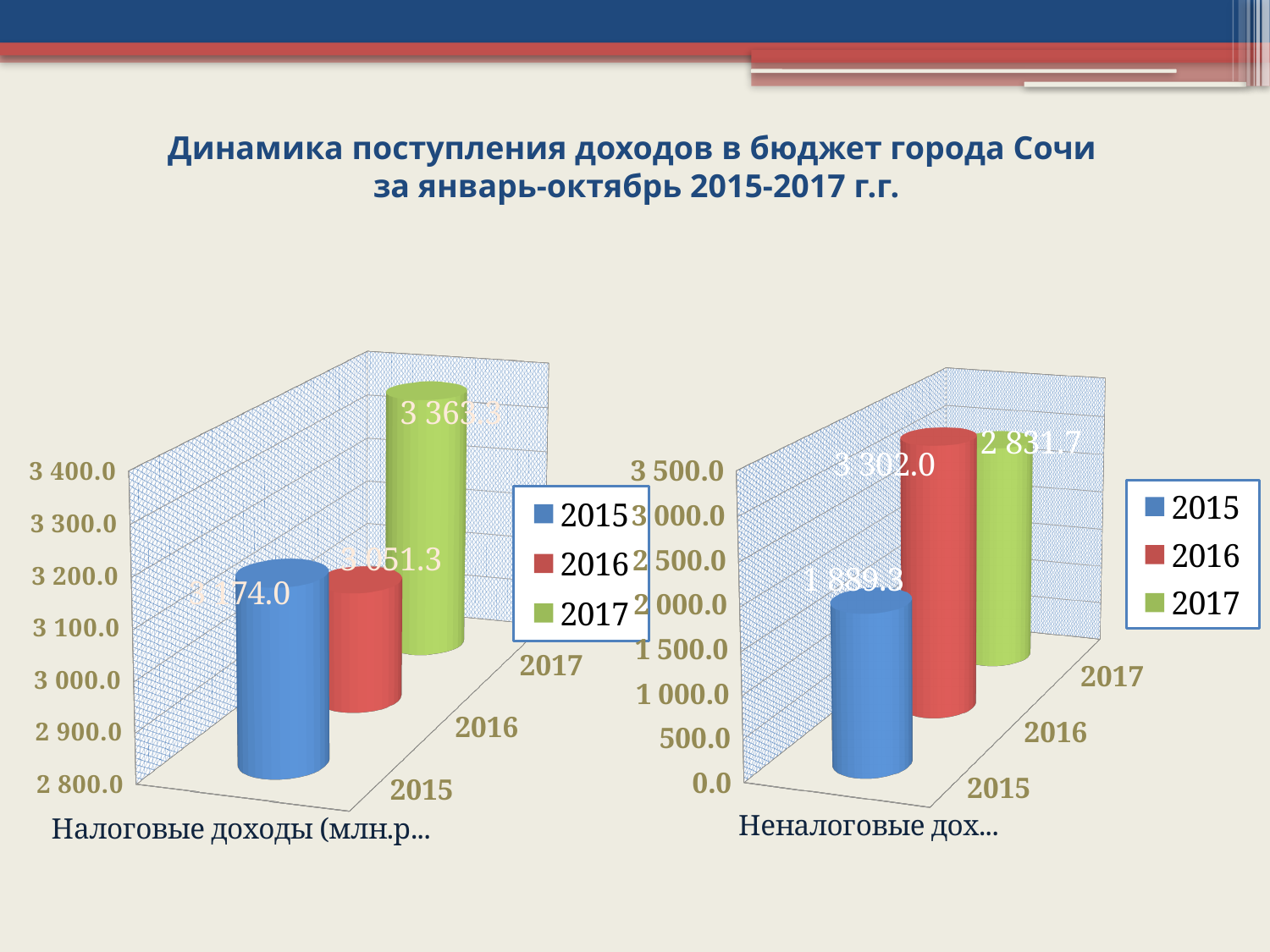
On the left chart (Налоговые доходы), which year has the lowest value? 2016 On the left chart (Налоговые доходы), is the value for 2016 larger than the value for 2015? No On the right chart (Неналоговые доходы), which year has the lowest value? 2015 On the right chart (Неналоговые доходы), what is the difference between the 2016 and 2015 values? 1 412.7 On the right chart (Неналоговые доходы), what is the value for 2016? 3 302.0 On the left chart (Налоговые доходы), what is the value for 2015? 3 174.0 On the right chart (Неналоговые доходы), which year has the highest value? 2016 What type of chart is the left chart (Налоговые доходы)? Bar chart How many series does the legend of the right chart list? 3 On the left chart (Налоговые доходы), which year has the highest value? 2017 On the right chart (Неналоговые доходы), what is the value for 2015? 1 889.3 On the left chart (Налоговые доходы), what is the value for 2017? 3 363.3